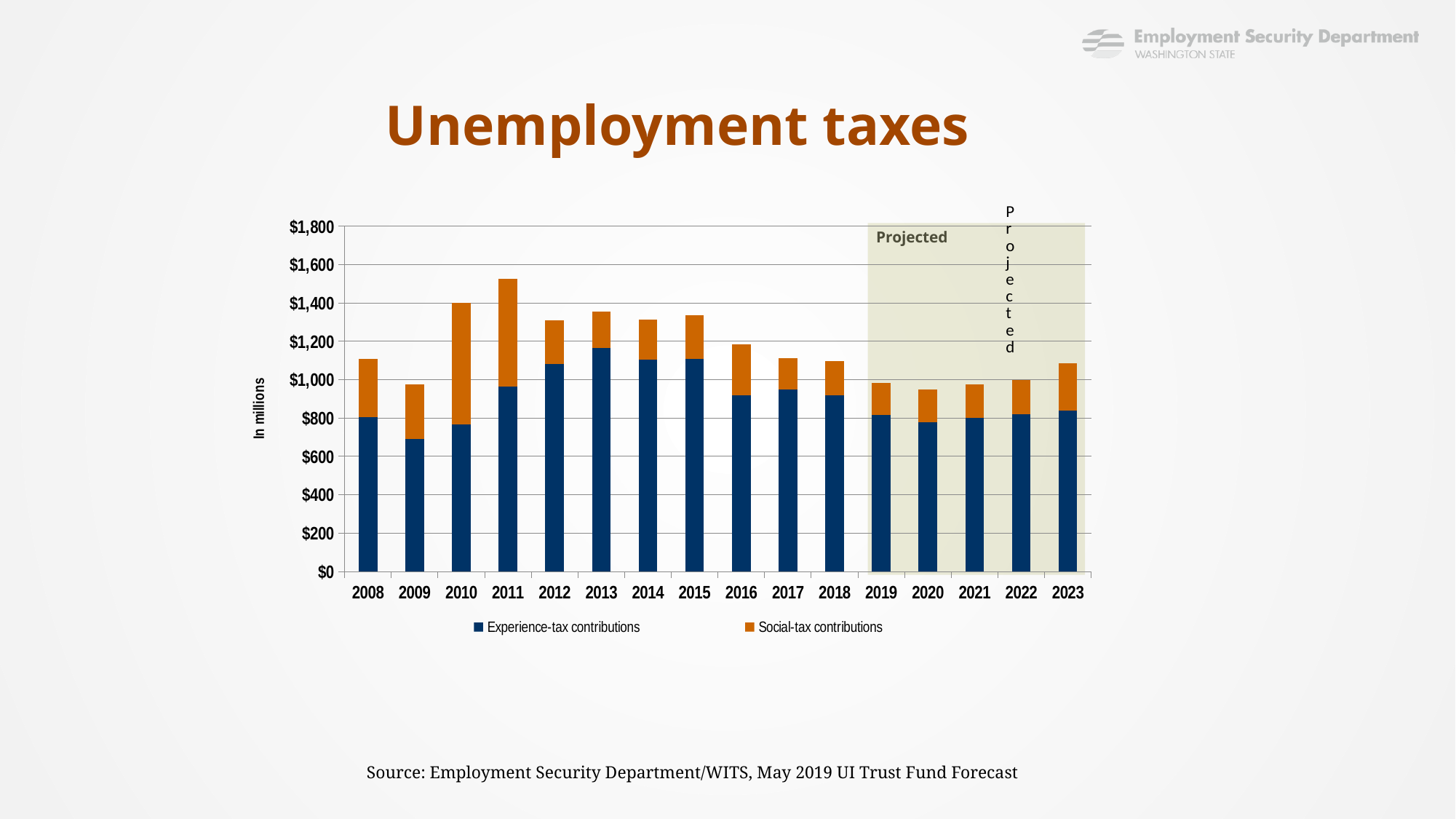
Which year has the lowest Experience-tax contributions? 2009 How many years are shown on the x axis? 16 What kind of chart is shown on the slide? Stacked bar chart Which year has the larger total, 2008 or 2010? 2010 How many series does the legend list? 2 Which year has the highest total unemployment taxes? 2011 What label is shown on the shaded region covering 2019 to 2023? Projected Which year has the highest Experience-tax contributions? 2013 Is the value of Experience-tax contributions for 2010 greater or less than $800? less Do the total bars rise or fall from 2019 to 2023? rise Is the total for 2009 greater or less than $1,000? less Is the total for 2011 greater or less than $1,400? greater